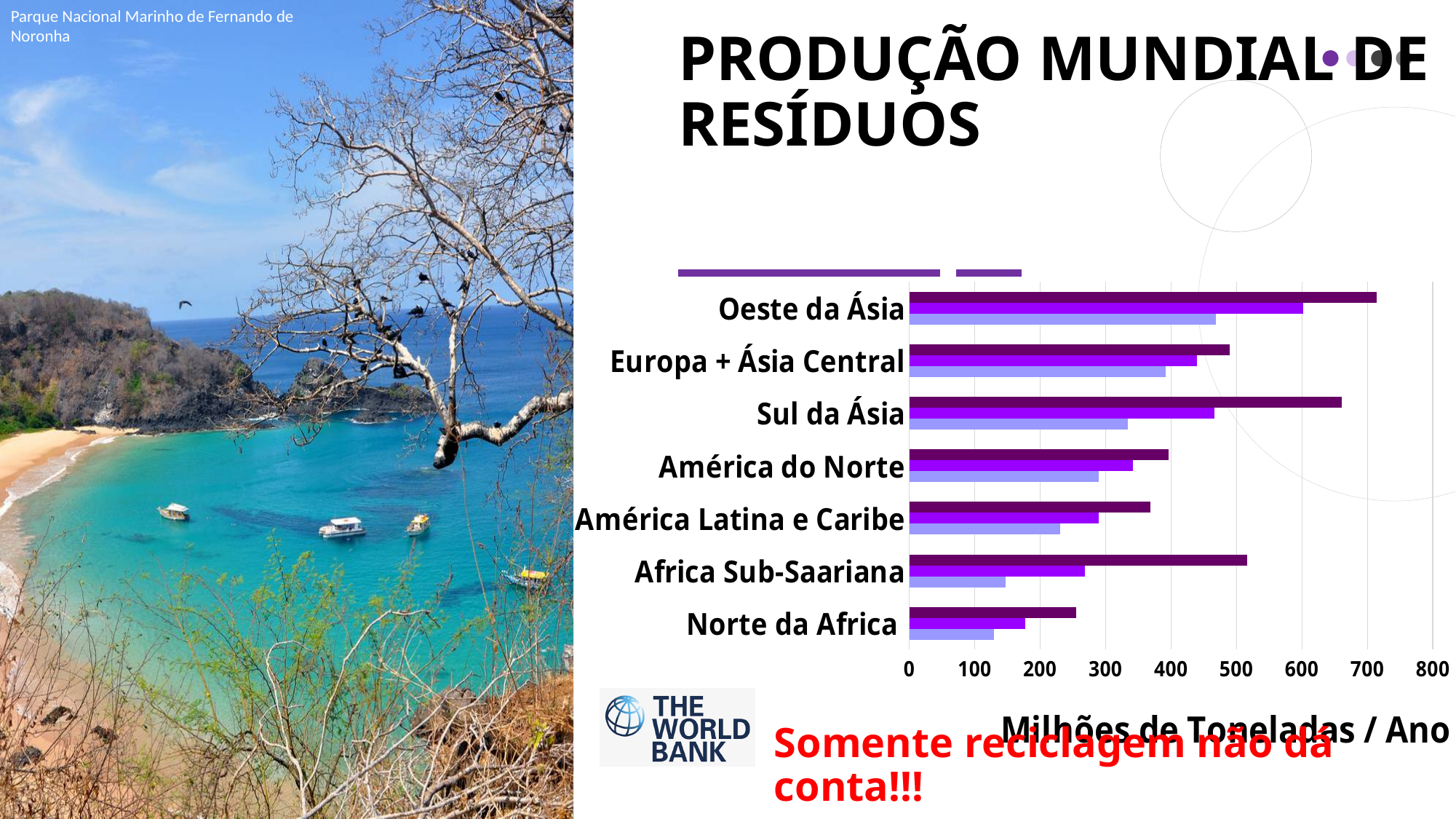
Which region has the shortest dark purple bar? Norte da Africa What kind of chart is shown on the slide? bar chart Which region has the longest light blue bar? Oeste da Ásia What unit label is shown below the x axis of the chart? Milhões de Toneladas / Ano Is the dark purple bar longer for Sul da Ásia or for Europa + Ásia Central? Sul da Ásia How many bars are plotted for each region on the chart? 3 Which region has the longest dark purple bar? Oeste da Ásia How many regions (categories) are listed on the chart? 7 What is the title of the chart on the slide? PRODUÇÃO MUNDIAL DE RESÍDUOS Is the dark purple value for Africa Sub-Saariana greater or less than 400? greater Is the dark purple value for Oeste da Ásia greater or less than 600? greater Is the light blue value for Norte da Africa greater or less than 200? less